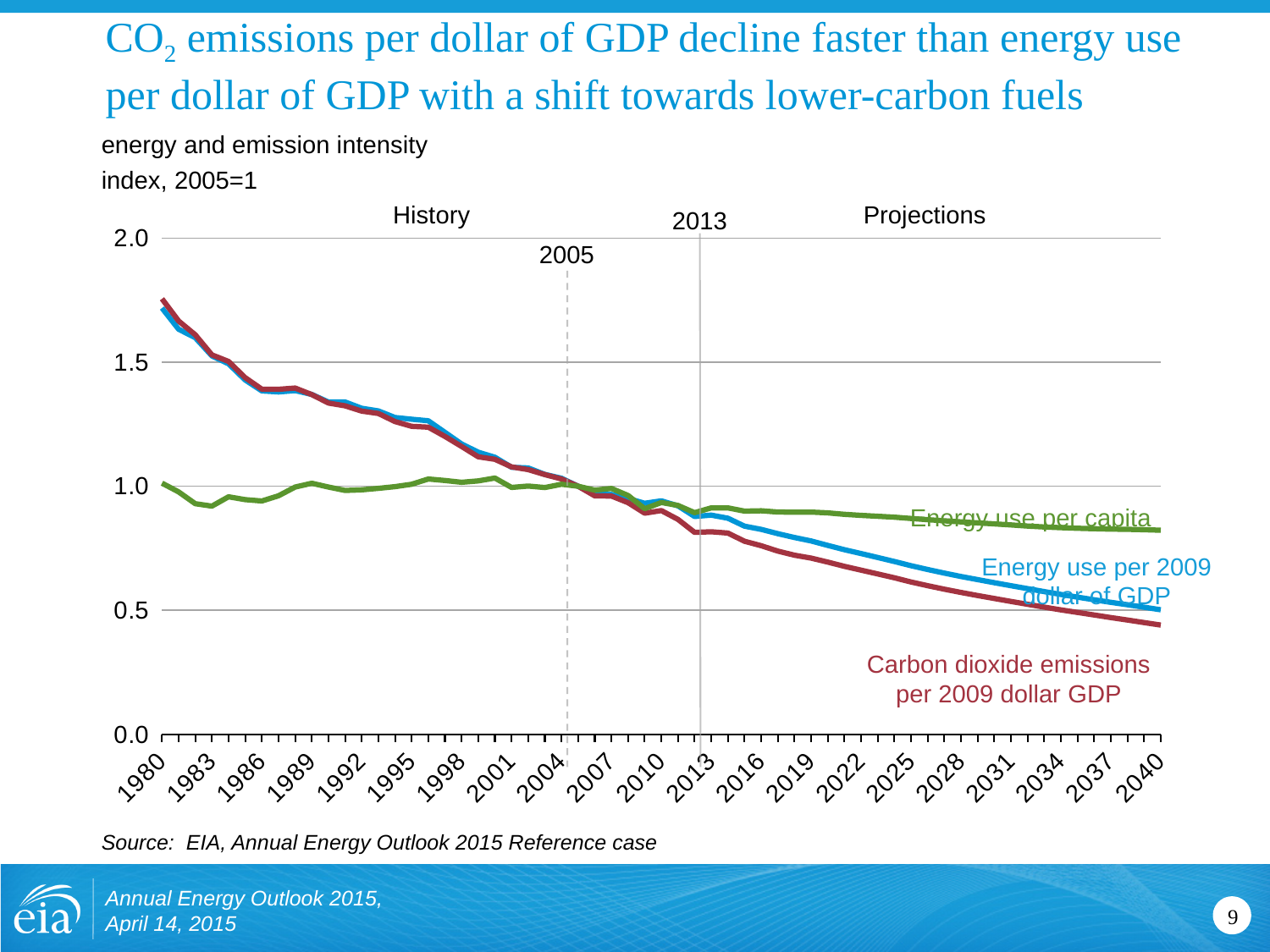
What base year is the index set to 1 in this chart? 2005 What kind of chart is shown on the slide? line chart What is the last year shown on the x axis? 2040 Is the value for Carbon dioxide emissions per 2009 dollar GDP in 2040 greater or less than 0.5? less How many series are plotted on the chart? 3 Does the value for Energy use per 2009 dollar of GDP rise or fall from 1980 to 2040? fall Does the value for Carbon dioxide emissions per 2009 dollar GDP rise or fall from 1980 to 2040? fall In 2040, which is larger: Energy use per capita or Carbon dioxide emissions per 2009 dollar GDP? Energy use per capita Is the value for Energy use per 2009 dollar of GDP in 1980 greater or less than 1.5? greater Is the value for Energy use per capita in 2040 greater or less than 1.0? less In 1980, which is larger: Energy use per capita or Energy use per 2009 dollar of GDP? Energy use per 2009 dollar of GDP Which series is labelled in green on the chart? Energy use per capita